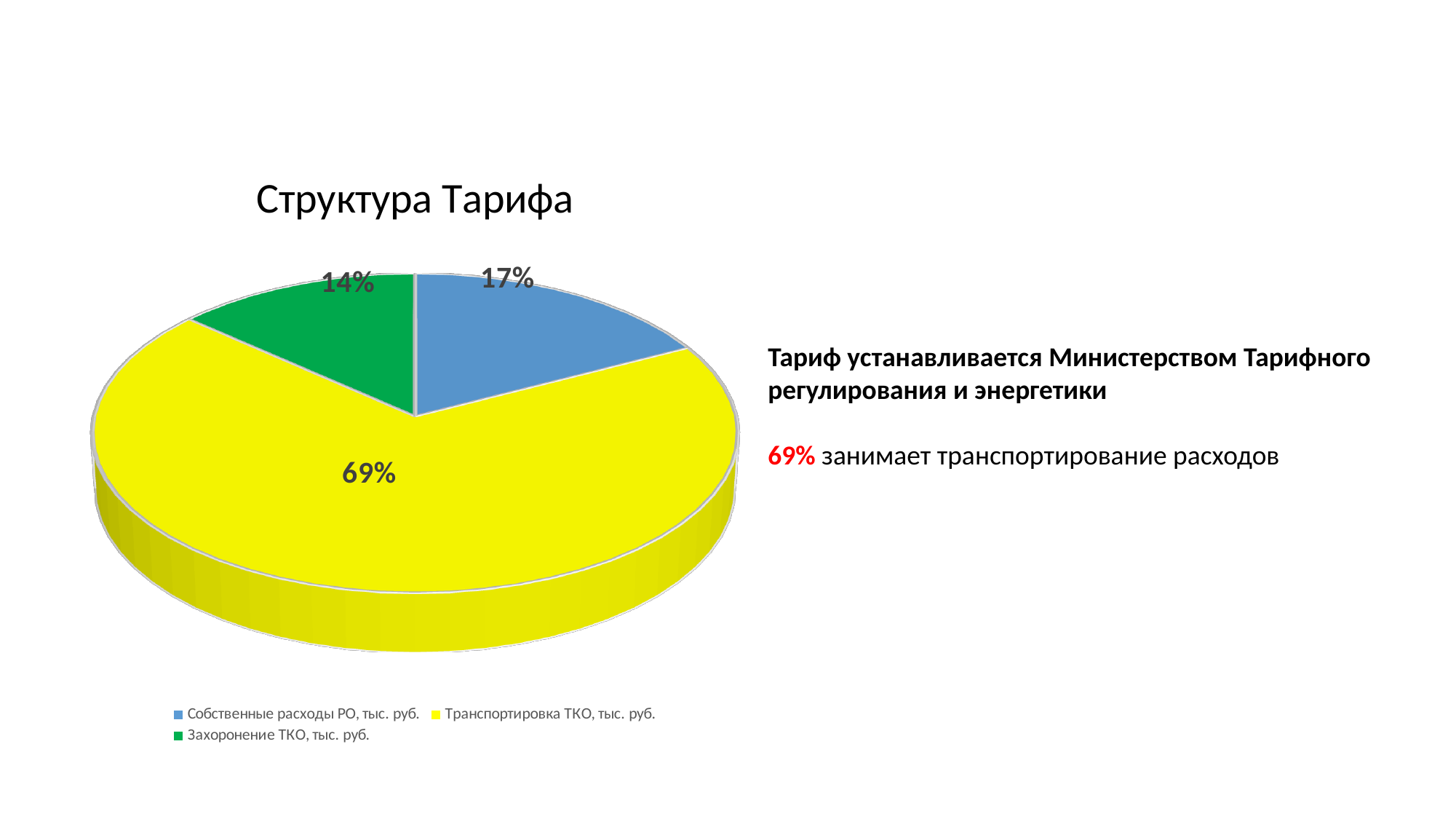
What share of the pie does Транспортировка ТКО, тыс. руб. take? 69% Which category has the largest slice of the pie? Транспортировка ТКО, тыс. руб. What share of the pie does Собственные расходы РО, тыс. руб. take? 17% How many categories does the pie chart show? 3 What share of the pie does Захоронение ТКО, тыс. руб. take? 14% What is the title of the chart? Структура Тарифа Which category has the smallest slice of the pie? Захоронение ТКО, тыс. руб. What is the difference in percentage points between Транспортировка ТКО and Собственные расходы РО? 52 Which is larger, the slice for Собственные расходы РО or the slice for Захоронение ТКО? Собственные расходы РО, тыс. руб. What kind of chart is shown on the slide? pie chart What colour is the slice for Захоронение ТКО, тыс. руб.? green What is the difference in percentage points between Собственные расходы РО and Захоронение ТКО? 3